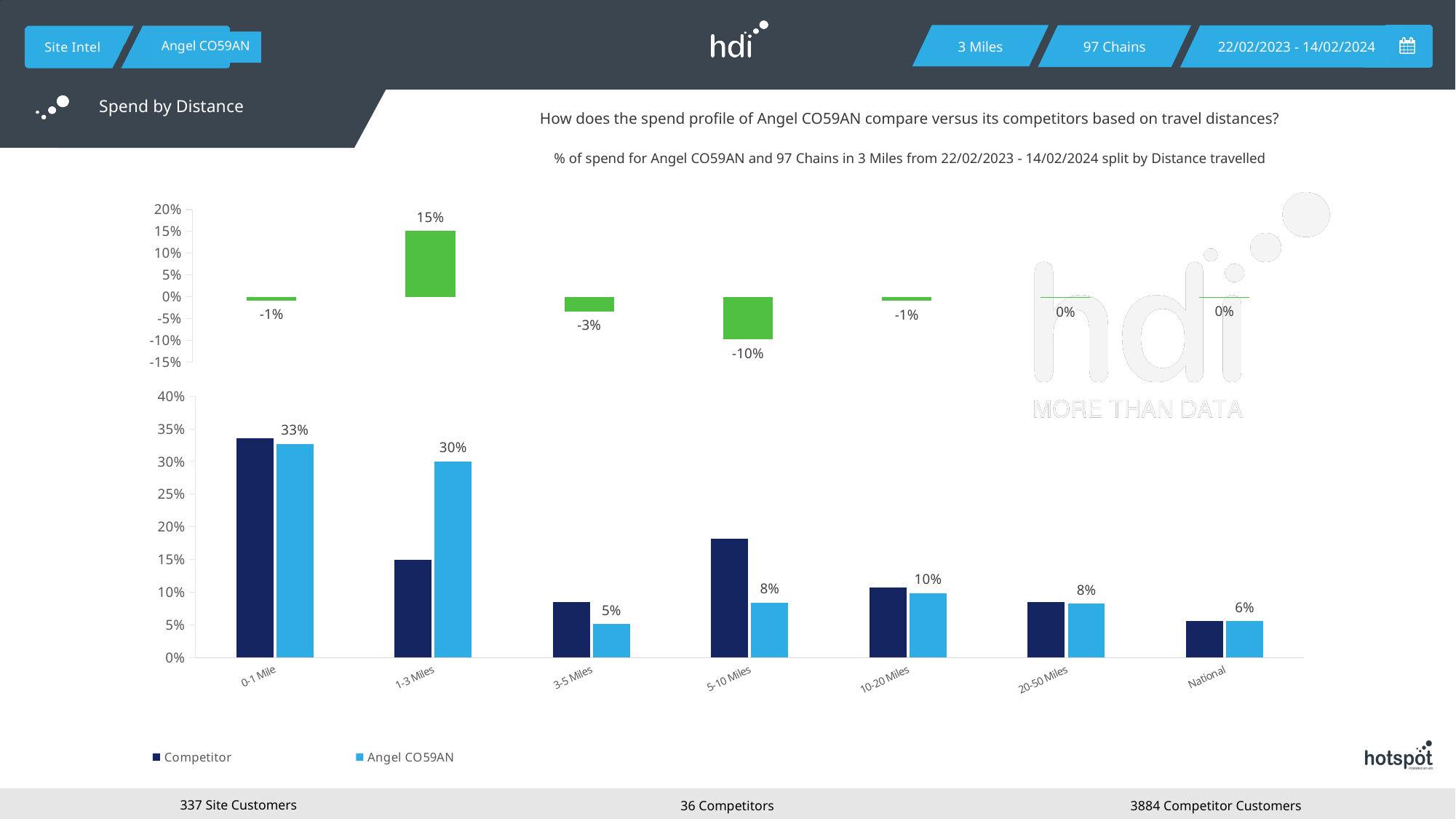
In the top chart, what is the value for 5-10 Miles? -10% In the bottom chart, which distance band has the highest Angel CO59AN value? 0-1 Mile In the bottom chart, is the Competitor value for 5-10 Miles greater or less than 15%? greater In the bottom chart, what is the value for Angel CO59AN at National? 6% How many series does the legend of the bottom chart list? 2 How many distance bands are shown on the x axis of the bottom chart? 7 What kind of chart is the bottom chart? Bar chart In the bottom chart, what is the difference between the Angel CO59AN values for 0-1 Mile and 1-3 Miles? 3% In the top chart, which distance band has the lowest value? 5-10 Miles In the bottom chart, what is the value for Angel CO59AN at 1-3 Miles? 30% In the bottom chart, at 1-3 Miles, which series has the larger value, Competitor or Angel CO59AN? Angel CO59AN In the top chart, which distance band has the highest value? 1-3 Miles